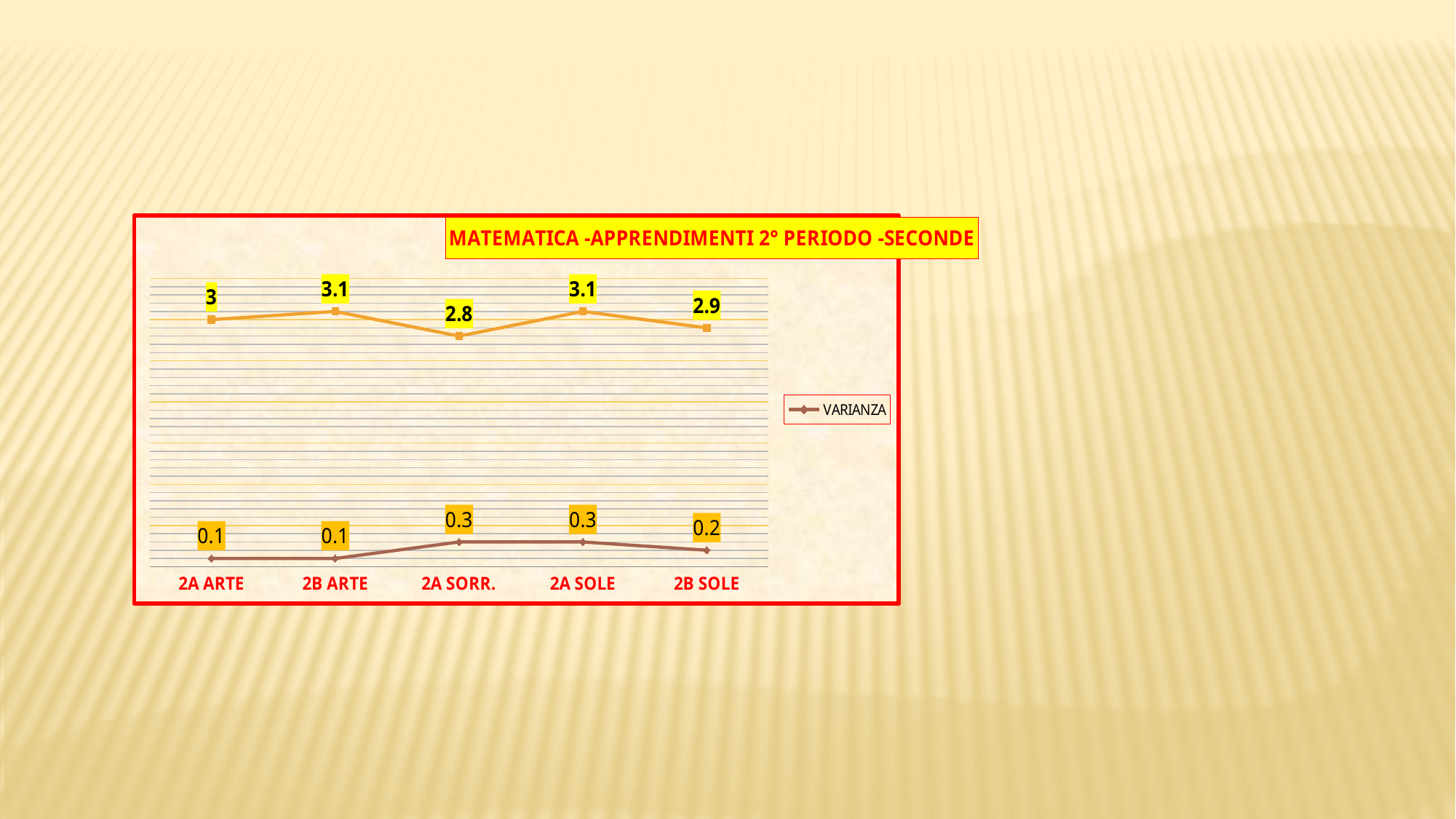
How many categories are shown on the x axis of the chart? 5 What is the VARIANZA value for 2A SORR.? 0.3 Which is larger, the VARIANZA value for 2A SOLE or for 2B SOLE? 2A SOLE What is the value of the upper orange line for 2A SORR.? 2.8 What is the difference between the VARIANZA values for 2A SORR. and 2A ARTE? 0.2 How many series does the chart's legend list? 1 What is the value of the upper orange line for 2B SOLE? 2.9 What kind of chart is shown on the slide? line chart What is the difference between the upper orange line values for 2B ARTE and 2A SORR.? 0.3 Which category has the lowest value on the upper orange line? 2A SORR. What is the title of the chart? MATEMATICA -APPRENDIMENTI 2° PERIODO -SECONDE What is the VARIANZA value for 2B SOLE? 0.2